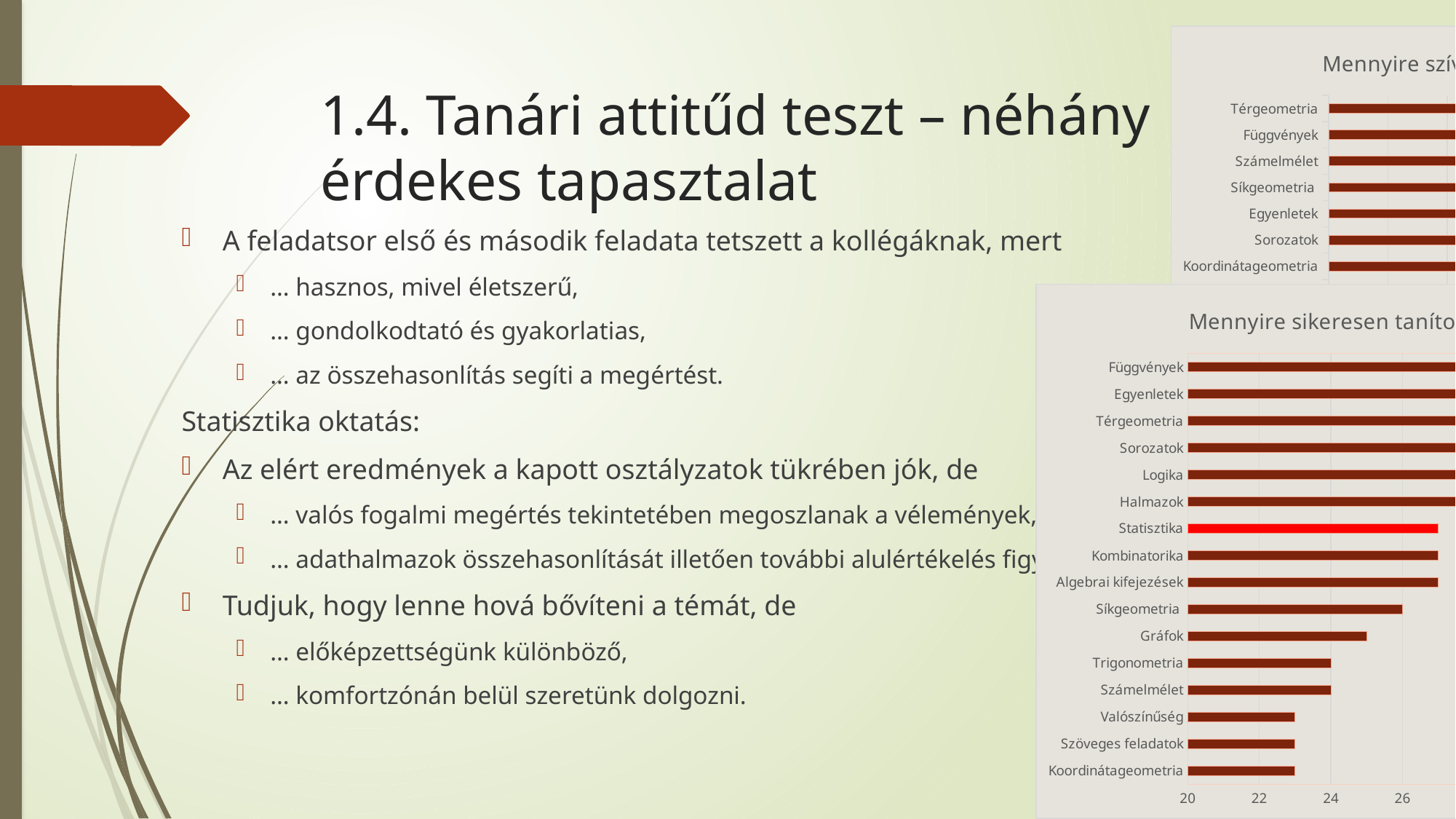
In the chart at the bottom right, is the value for Koordinátageometria greater or less than 24? less In the chart at the bottom right, which category's bar is highlighted in bright red? Statisztika In the chart at the bottom right, which is larger, the value for Síkgeometria or the value for Gráfok? Síkgeometria In the chart at the bottom right, what is the value for Síkgeometria? 26 In the chart at the bottom right, is the value for Gráfok greater or less than 24? greater In the chart at the bottom right, which is larger, the value for Trigonometria or the value for Koordinátageometria? Trigonometria In the chart at the bottom right, what is the difference between the values for Síkgeometria and Trigonometria? 2 How many categories are shown in the chart at the bottom right? 16 What kind of chart is the chart at the bottom right of the slide? bar chart In the chart at the bottom right, is the value for Valószínűség greater or less than 22? greater In the chart at the bottom right, what is the value for Számelmélet? 24 In the chart at the bottom right, what is the value for Trigonometria? 24